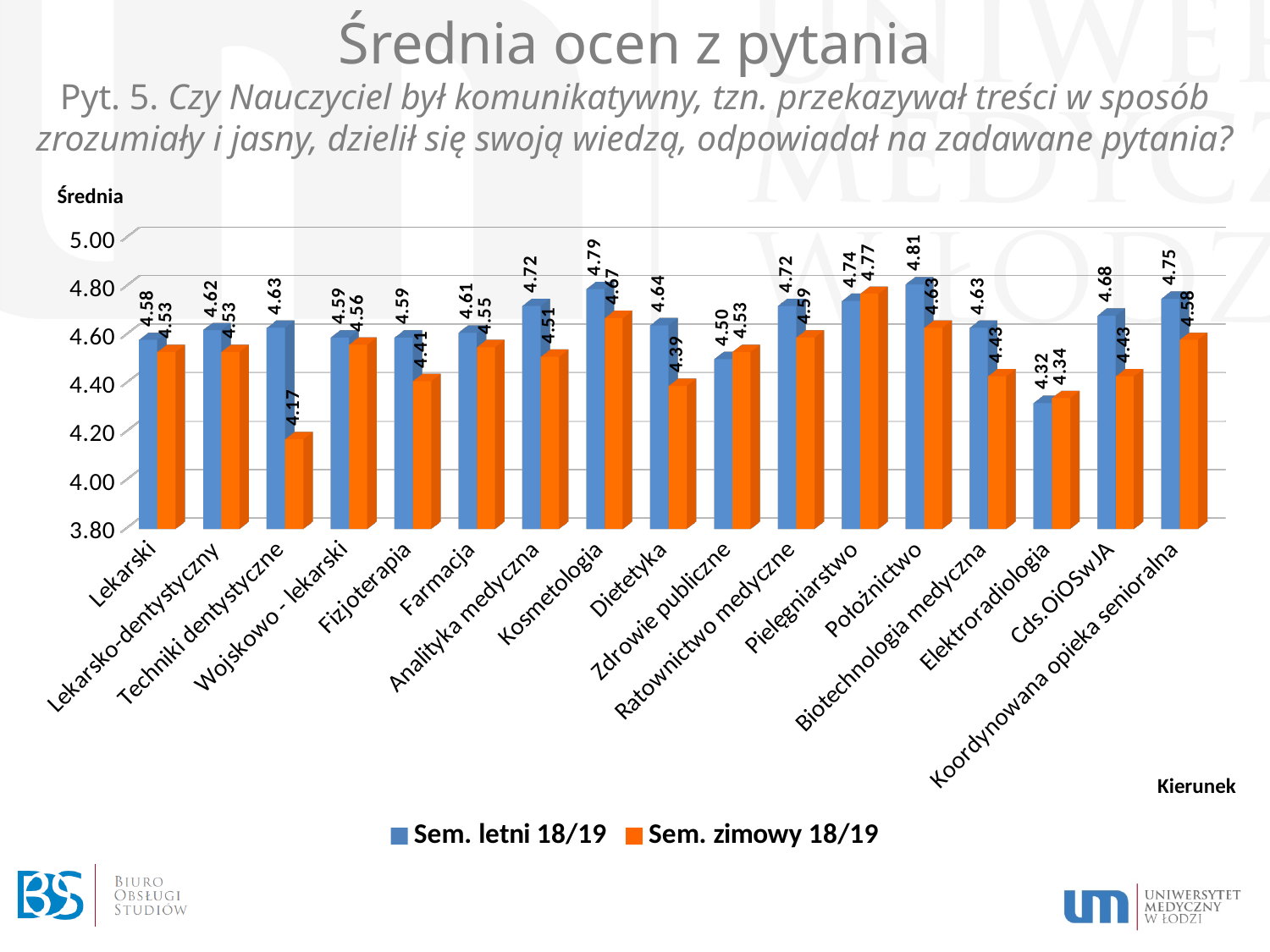
What is the Sem. letni 18/19 value for Położnictwo? 4.81 Which category has the highest Sem. letni 18/19 value? Położnictwo Which category has the lowest Sem. letni 18/19 value? Elektroradiologia What kind of chart is shown on the slide? Bar chart How many categories (kierunki) are shown on the x axis? 17 How many series does the legend list? 2 What is the Sem. zimowy 18/19 value for Kosmetologia? 4.67 Is the Sem. zimowy 18/19 value for Dietetyka greater or less than 4.40? less What is the Sem. zimowy 18/19 value for Techniki dentystyczne? 4.17 Which category has the lowest Sem. zimowy 18/19 value? Techniki dentystyczne For Pielęgniarstwo, which is larger: the Sem. letni 18/19 value or the Sem. zimowy 18/19 value? Sem. zimowy 18/19 What is the difference between the Sem. letni 18/19 and Sem. zimowy 18/19 values for Techniki dentystyczne? 0.46